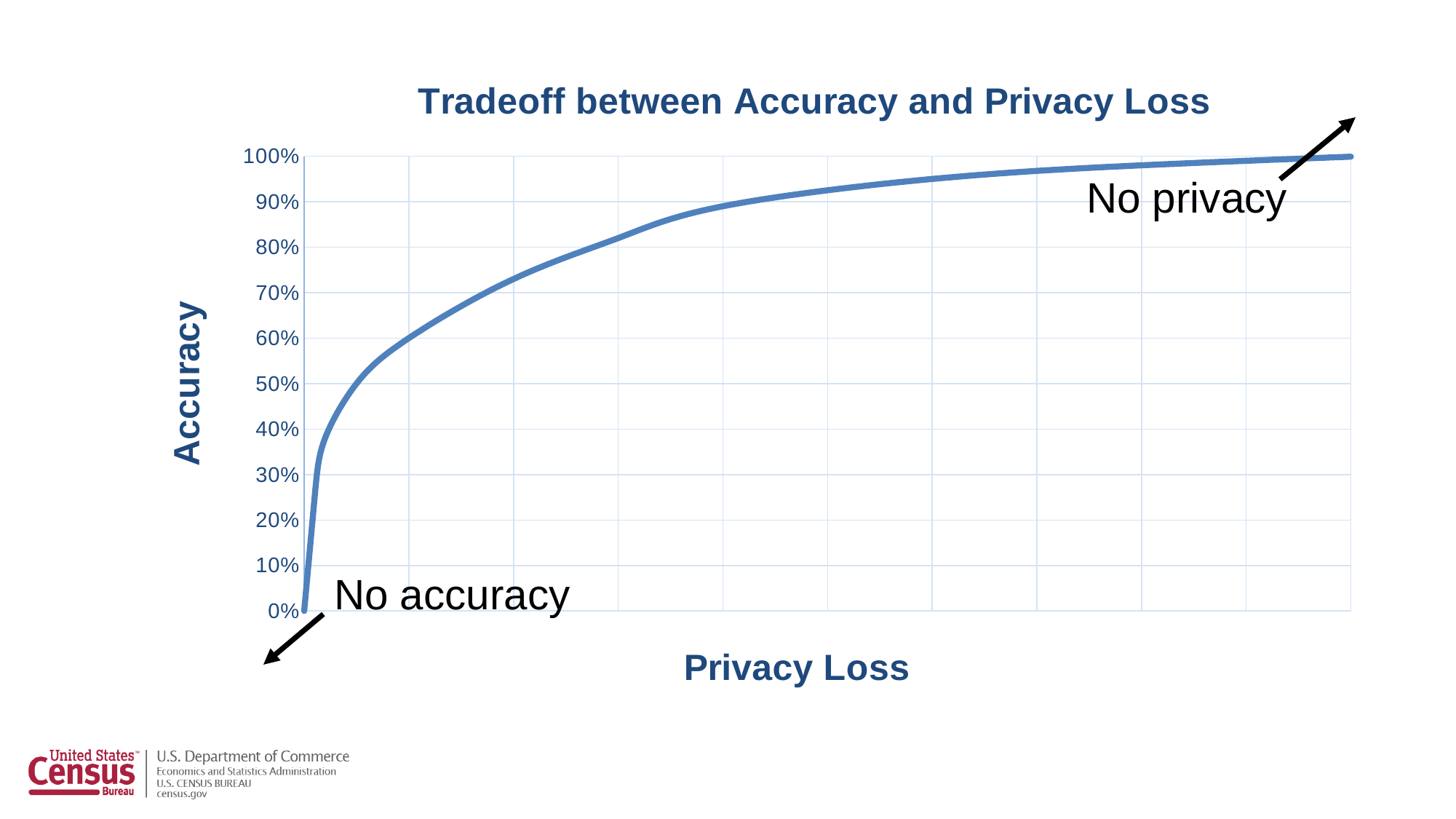
How many lines are plotted on the chart? 1 What is the label of the x axis? Privacy Loss Is the accuracy at the 'No accuracy' end of the curve greater or less than 10%? less Does accuracy rise or fall as privacy loss increases along the x axis? rise What kind of chart is shown on the slide? line chart What is the title of the chart? Tradeoff between Accuracy and Privacy Loss Is the accuracy at the 'No privacy' end of the curve greater or less than 90%? greater